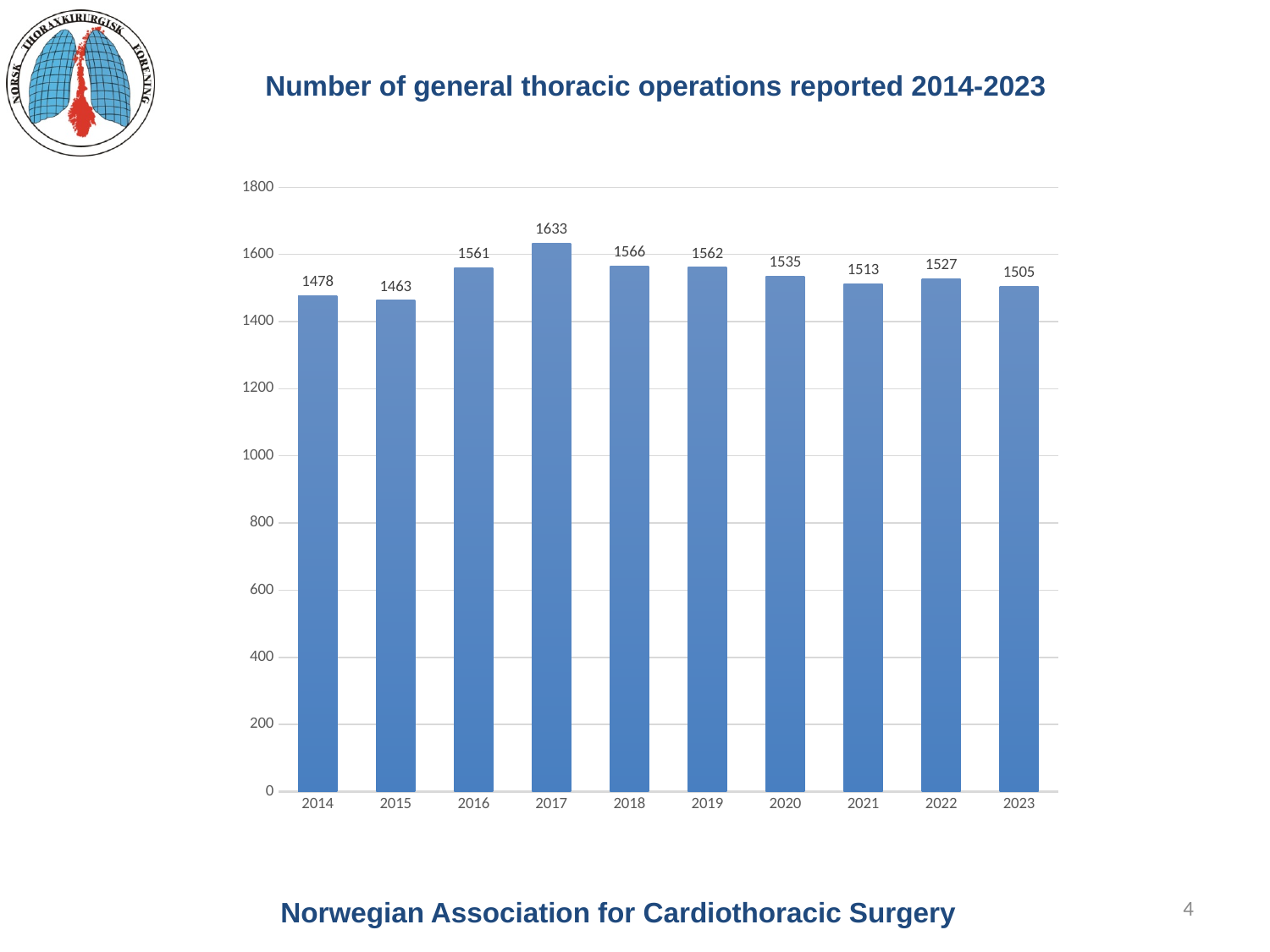
How many general thoracic operations were reported in 2017? 1633 How many years are shown on the x axis? 10 Which year has the lowest number of general thoracic operations? 2015 What is the title of the chart? Number of general thoracic operations reported 2014-2023 Which year has a larger value, 2016 or 2020? 2016 Is the value for 2019 greater or less than 1400? greater What is the value shown for 2014? 1478 Which year has the highest number of general thoracic operations? 2017 What kind of chart is shown on the slide? Bar chart What is the difference between the values for 2022 and 2021? 14 What is the value shown for 2023? 1505 What is the difference between the values for 2017 and 2015? 170